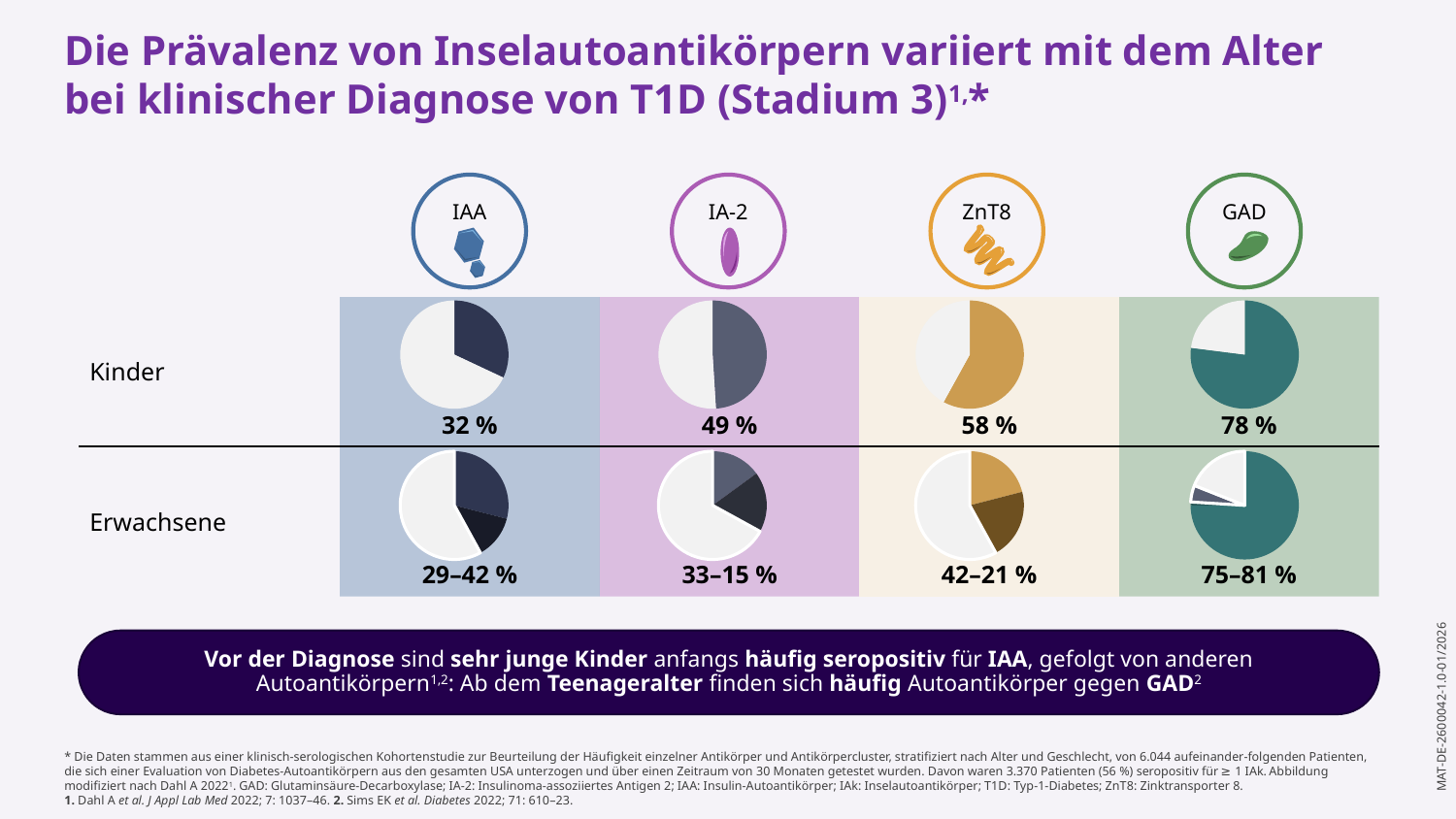
In the Erwachsene row, what value range is shown for IA-2? 33–15 % In the Kinder row, what is the value shown for IAA? 32 % In the Erwachsene row, what value range is shown for GAD? 75–81 % In the Kinder row, which autoantibody has the highest prevalence? GAD Which four autoantibodies are labelled above the columns of pie charts? IAA, IA-2, ZnT8, GAD How many pie charts are shown on the slide in total? 8 What kind of charts are used to show the prevalence values on the slide? Pie charts In the Kinder row, which autoantibody has the lowest prevalence? IAA In the Kinder row, what is the value shown for GAD? 78 % In the Kinder row, what is the difference between the GAD value and the IAA value? 46 % In the Kinder row, what is the value shown for ZnT8? 58 % In the Kinder row, which is larger: the value for IA-2 or the value for ZnT8? ZnT8